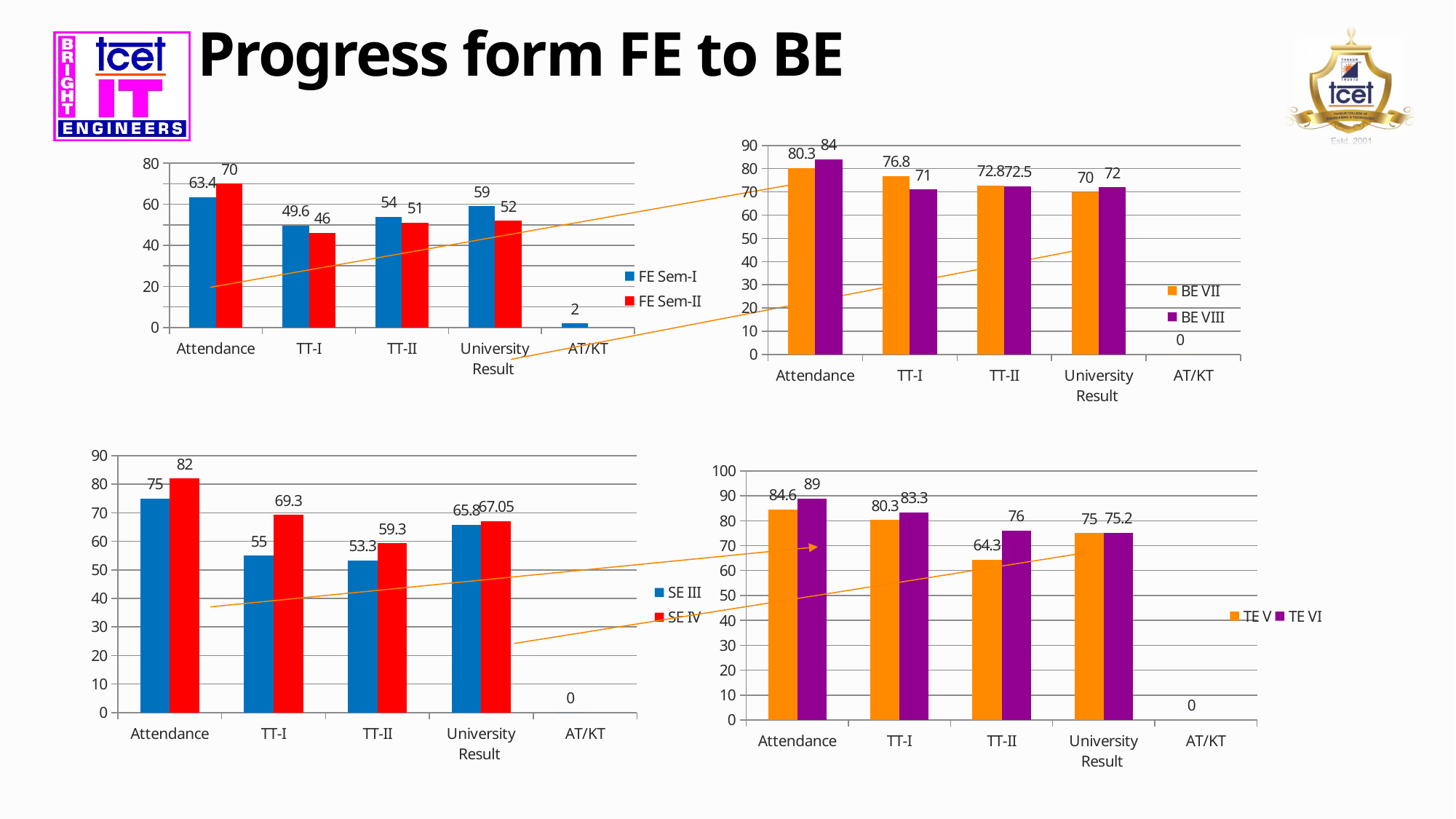
In the bottom-left chart, which category has the lowest SE III value? AT/KT In the top-left chart, what is the difference between the FE Sem-I and FE Sem-II values for University Result? 7 In the top-right chart, which is larger for TT-I: BE VII or BE VIII? BE VII In the top-left chart, what is the FE Sem-I value for TT-I? 49.6 In the top-right chart, what is the BE VIII value for Attendance? 84 In the bottom-right chart, what is the difference between the TE VI and TE V values for Attendance? 4.4 In the bottom-left chart, what is the SE IV value for TT-I? 69.3 In the bottom-left chart, what is the SE IV value for University Result? 67.05 In the top-right chart, which category has the highest BE VII value? Attendance In the top-left chart, what is the FE Sem-II value for Attendance? 70 In the bottom-right chart, what is the TE VI value for TT-II? 76 How many series does the legend of the bottom-right chart list? 2